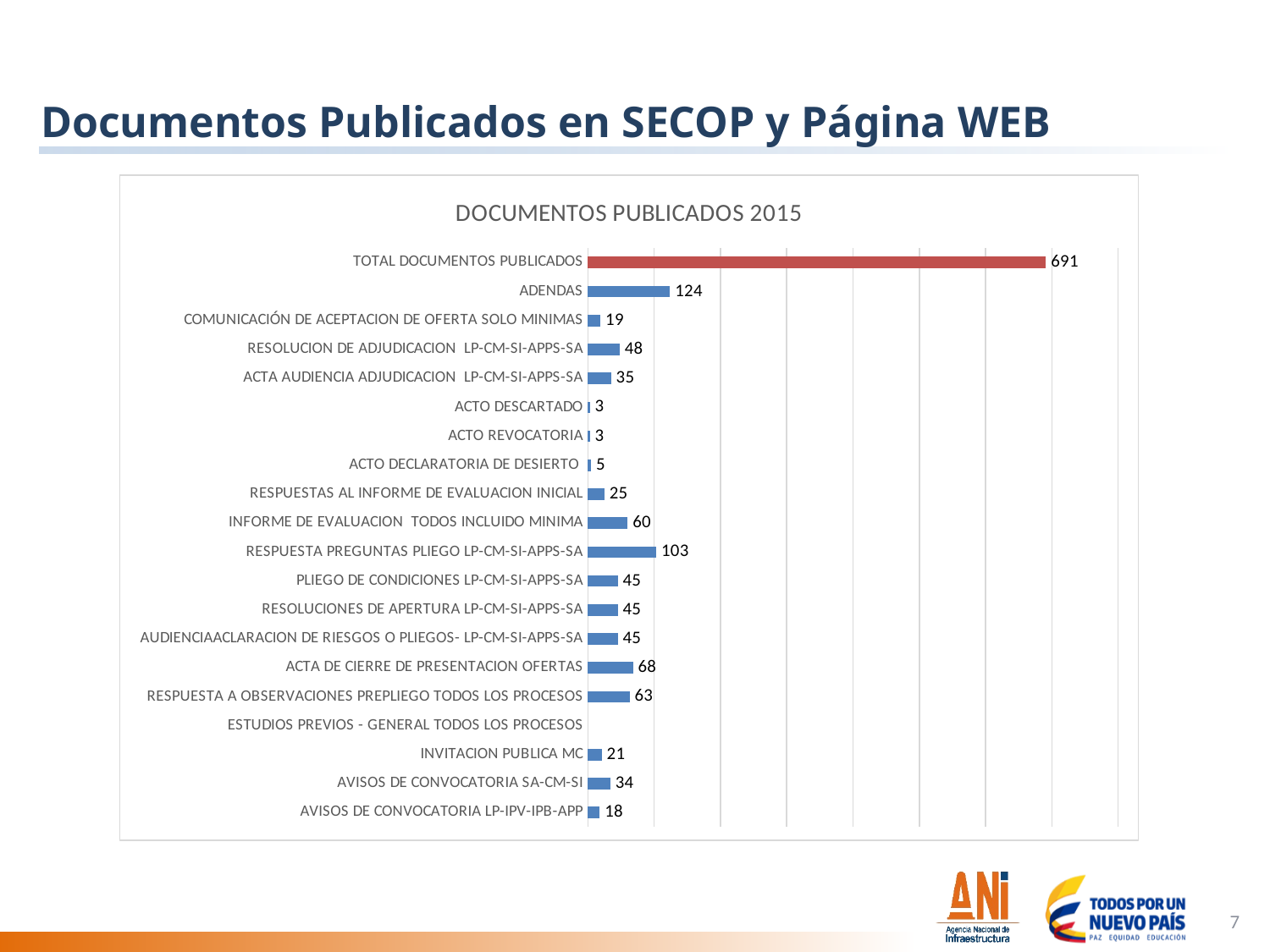
What is the value for ADENDAS in the DOCUMENTOS PUBLICADOS 2015 chart? 124 What kind of chart is shown on the slide? Bar chart What is the value for AVISOS DE CONVOCATORIA LP-IPV-IPB-APP? 18 How many categories are listed on the vertical axis of the chart? 20 What is the difference between the values for ADENDAS and RESPUESTA PREGUNTAS PLIEGO LP-CM-SI-APPS-SA? 21 What is the difference between the values for ACTA DE CIERRE DE PRESENTACION OFERTAS and RESPUESTA A OBSERVACIONES PREPLIEGO TODOS LOS PROCESOS? 5 What is the value for RESPUESTA PREGUNTAS PLIEGO LP-CM-SI-APPS-SA? 103 What is the value for TOTAL DOCUMENTOS PUBLICADOS? 691 Which is larger, the value for INFORME DE EVALUACION TODOS INCLUIDO MINIMA or the value for ACTA DE CIERRE DE PRESENTACION OFERTAS? ACTA DE CIERRE DE PRESENTACION OFERTAS Which category has the highest value in the chart? TOTAL DOCUMENTOS PUBLICADOS What is the value for ACTA DE CIERRE DE PRESENTACION OFERTAS? 68 Excluding TOTAL DOCUMENTOS PUBLICADOS, which category has the highest value? ADENDAS